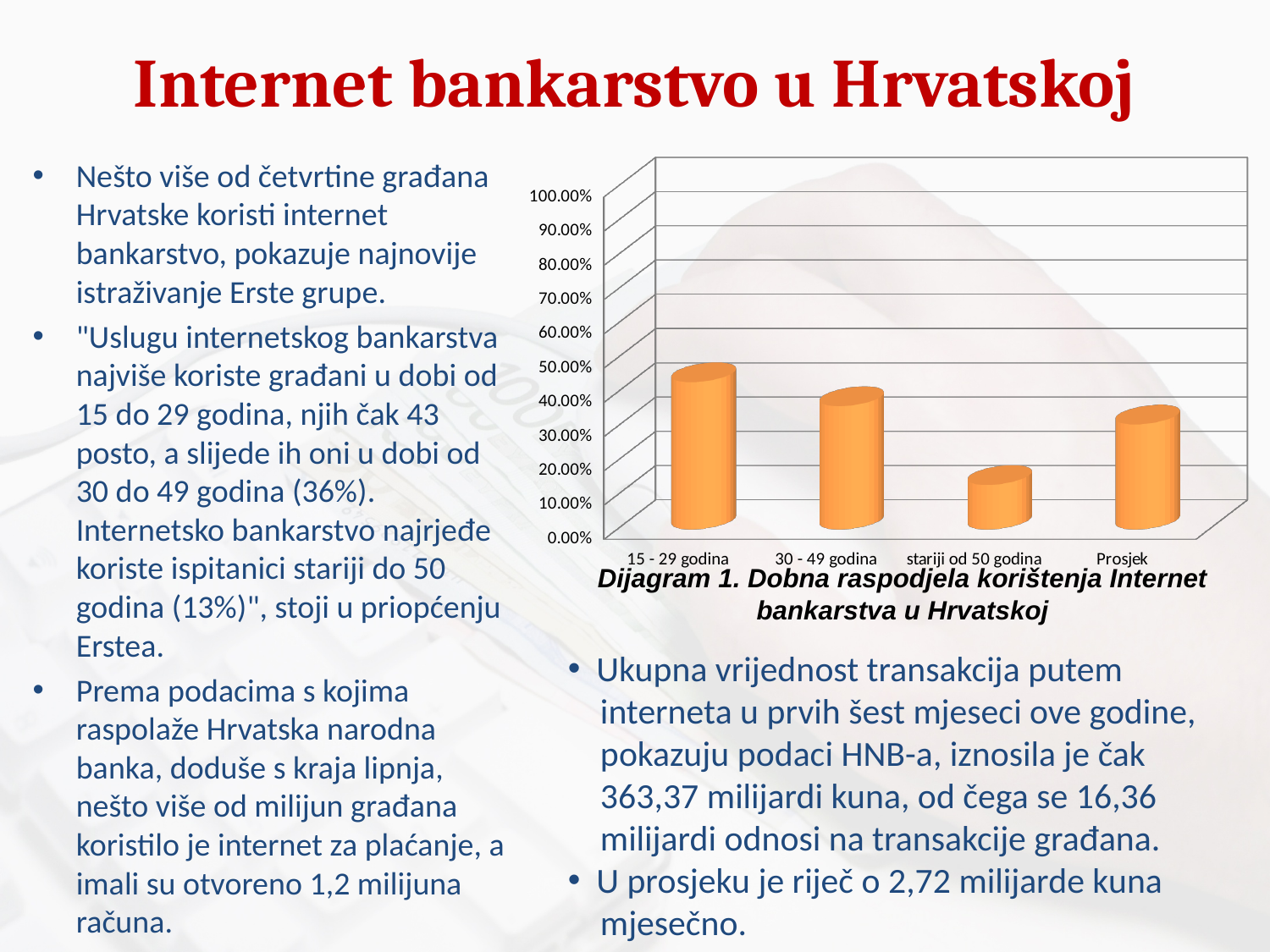
Do the values rise or fall from 15 - 29 godina to stariji od 50 godina? fall How many categories are shown on the x axis of the chart? 4 Which is larger, the value for 30 - 49 godina or the value for Prosjek? 30 - 49 godina Is the value for 15 - 29 godina greater or less than 40.00%? greater What is the caption given below the chart? Dijagram 1. Dobna raspodjela korištenja Internet bankarstva u Hrvatskoj What kind of chart is shown on the slide? bar chart Is the value for stariji od 50 godina greater or less than 20.00%? less Which category has the lowest bar in the chart? stariji od 50 godina Which is larger, the value for stariji od 50 godina or the value for 15 - 29 godina? 15 - 29 godina Is the value for 30 - 49 godina greater or less than 30.00%? greater Which category has the highest bar in the chart? 15 - 29 godina